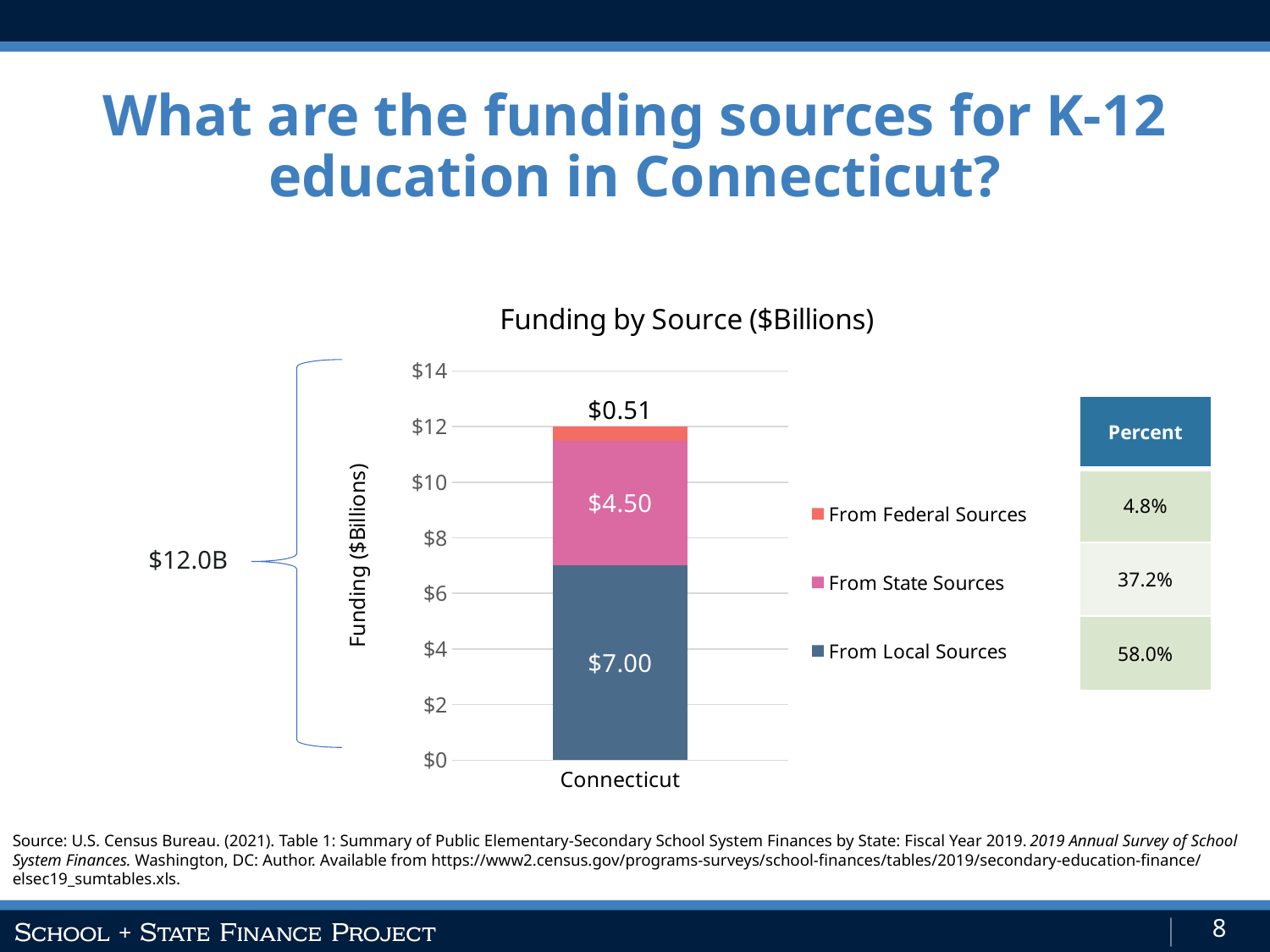
What is the total of the stacked bar for Connecticut? $12.0B What is the difference between the From Local Sources and From State Sources values? $2.50 Which is larger, the value for From State Sources or From Federal Sources? From State Sources Which funding source has the lowest value in the chart? From Federal Sources What percent of funding comes from State Sources according to the Percent table? 37.2% What is the value for From Federal Sources in the Funding by Source chart? $0.51 What kind of chart is shown on the slide? Stacked bar chart What is the title of the chart? Funding by Source ($Billions) What is the value for From State Sources in the Funding by Source chart? $4.50 What is the value for From Local Sources in the Funding by Source chart? $7.00 How many series does the legend list? 3 Which funding source has the highest value in the chart? From Local Sources